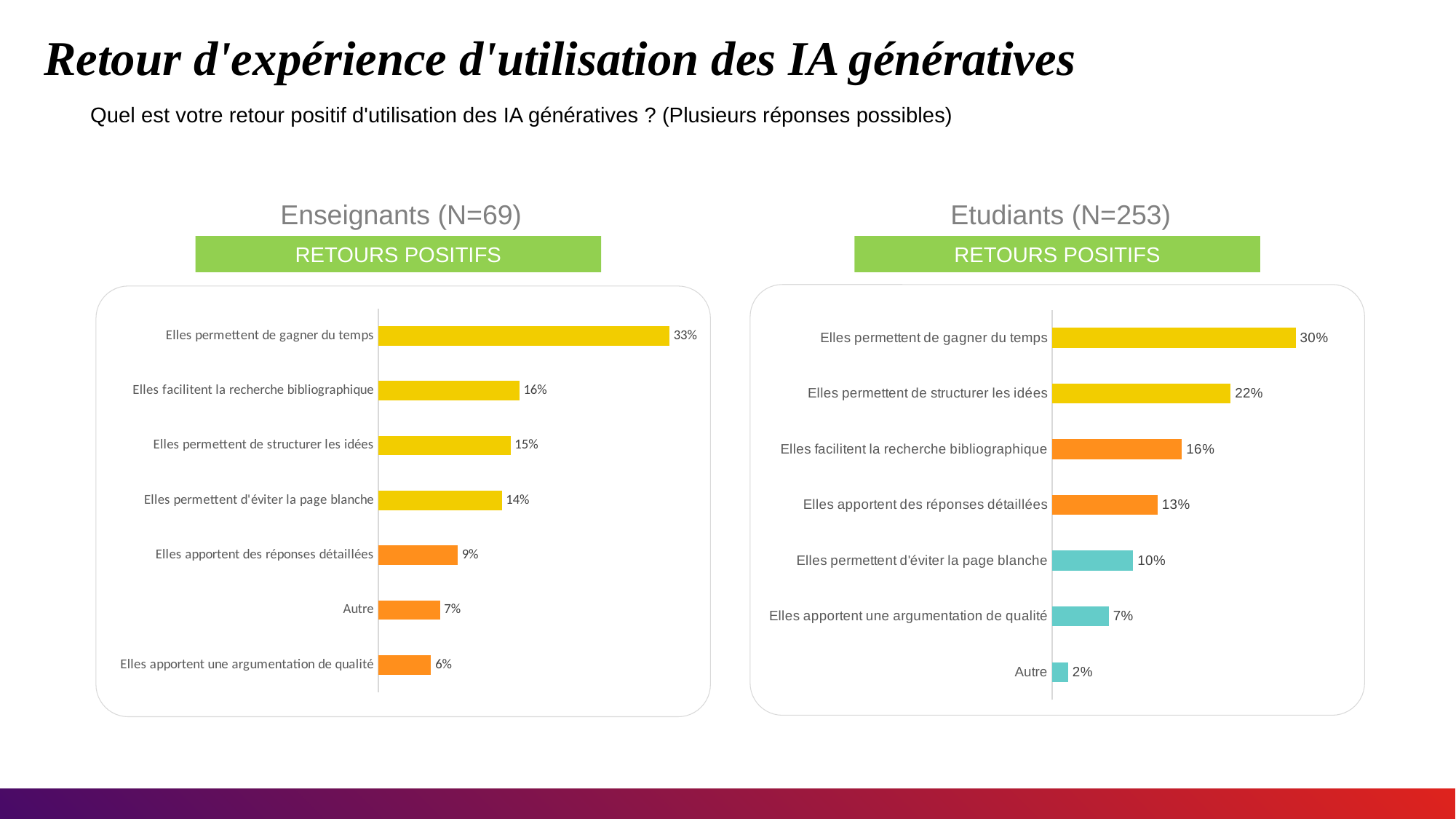
In the Enseignants (N=69) chart, what is the difference between "Elles permettent de gagner du temps" and "Elles facilitent la recherche bibliographique"? 17% What kind of chart is the Etudiants (N=253) chart? Bar chart How many categories are shown in the Enseignants (N=69) chart? 7 In the Enseignants (N=69) chart, what is the value for "Elles permettent de gagner du temps"? 33% In the Etudiants (N=253) chart, what is the value for "Autre"? 2% In the Etudiants (N=253) chart, which category has the highest value? Elles permettent de gagner du temps In the Etudiants (N=253) chart, what is the value for "Elles permettent de structurer les idées"? 22% In the Enseignants (N=69) chart, which category has the lowest value? Elles apportent une argumentation de qualité What is the text of the green header above each chart? RETOURS POSITIFS In the Etudiants (N=253) chart, what is the difference between "Elles permettent de gagner du temps" and "Elles permettent d'éviter la page blanche"? 20% In the Enseignants (N=69) chart, what is the value for "Autre"? 7% Which is larger: the value for "Elles permettent de structurer les idées" in the Enseignants (N=69) chart or in the Etudiants (N=253) chart? Etudiants (N=253)